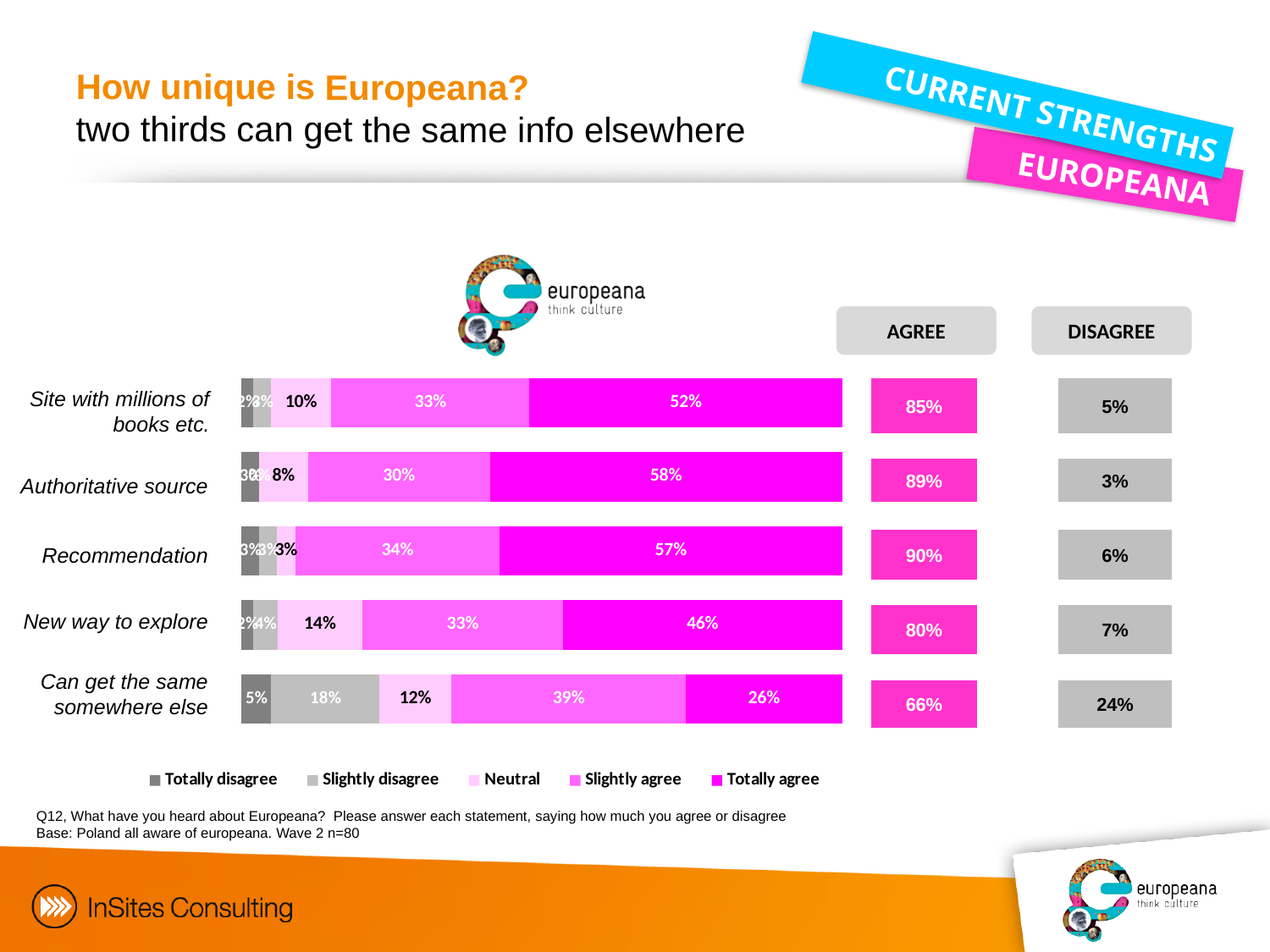
Which is larger: the 'Slightly agree' value for 'Recommendation' or for 'Authoritative source'? Recommendation What type of chart is shown on the slide? stacked bar chart Which statement has the lowest 'Totally agree' value? Can get the same somewhere else Which statement has the highest 'Totally agree' value? Authoritative source What is the 'Neutral' value for 'New way to explore'? 14% What is the 'Slightly disagree' value for 'Can get the same somewhere else'? 18% What is the 'Totally agree' value for 'Authoritative source'? 58% What is the 'Slightly agree' value for 'Can get the same somewhere else'? 39% What colour does the legend use for 'Totally agree'? magenta (bright pink) What is the difference between the 'Totally agree' values for 'Site with millions of books etc.' and 'Can get the same somewhere else'? 26% How many statements (categories) are plotted in the chart? 5 How many series does the legend list? 5